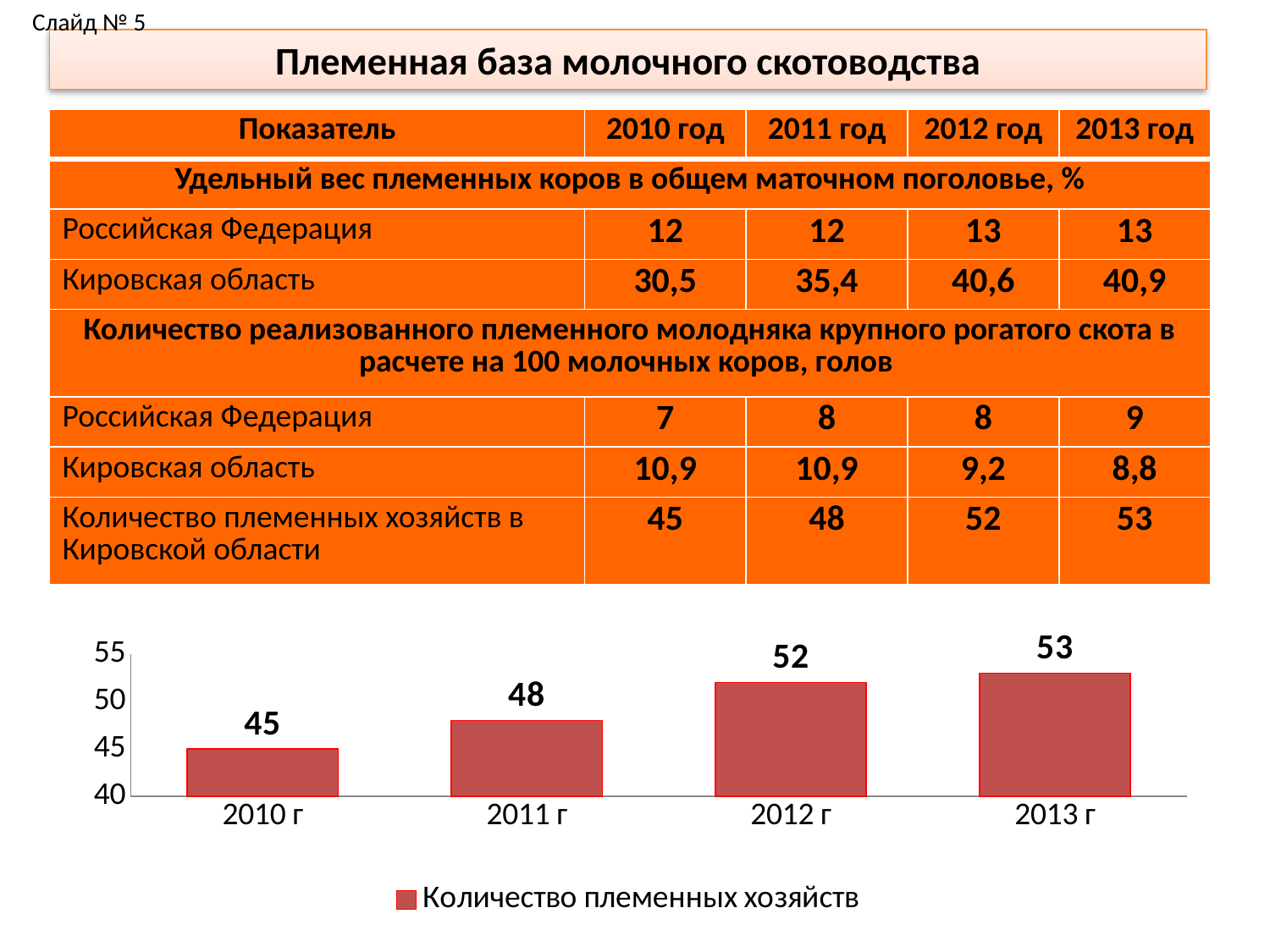
Which year has the lowest value in the bar chart? 2010 г What is the difference between the values for 2012 г and 2011 г in the bar chart? 4 How many series does the legend of the bar chart list? 1 What is the difference between the values for 2013 г and 2010 г in the bar chart? 8 Is the value for 2011 г in the bar chart greater or less than 50? less What is the value for 2012 г in the bar chart? 52 Do the values in the bar chart rise or fall from 2010 г to 2013 г? rise How many years are shown on the x axis of the bar chart? 4 What kind of chart is shown on the slide? bar chart What is the value for 2010 г in the bar chart? 45 Which is larger in the bar chart, the value for 2011 г or the value for 2012 г? 2012 г Which year has the highest value in the bar chart? 2013 г